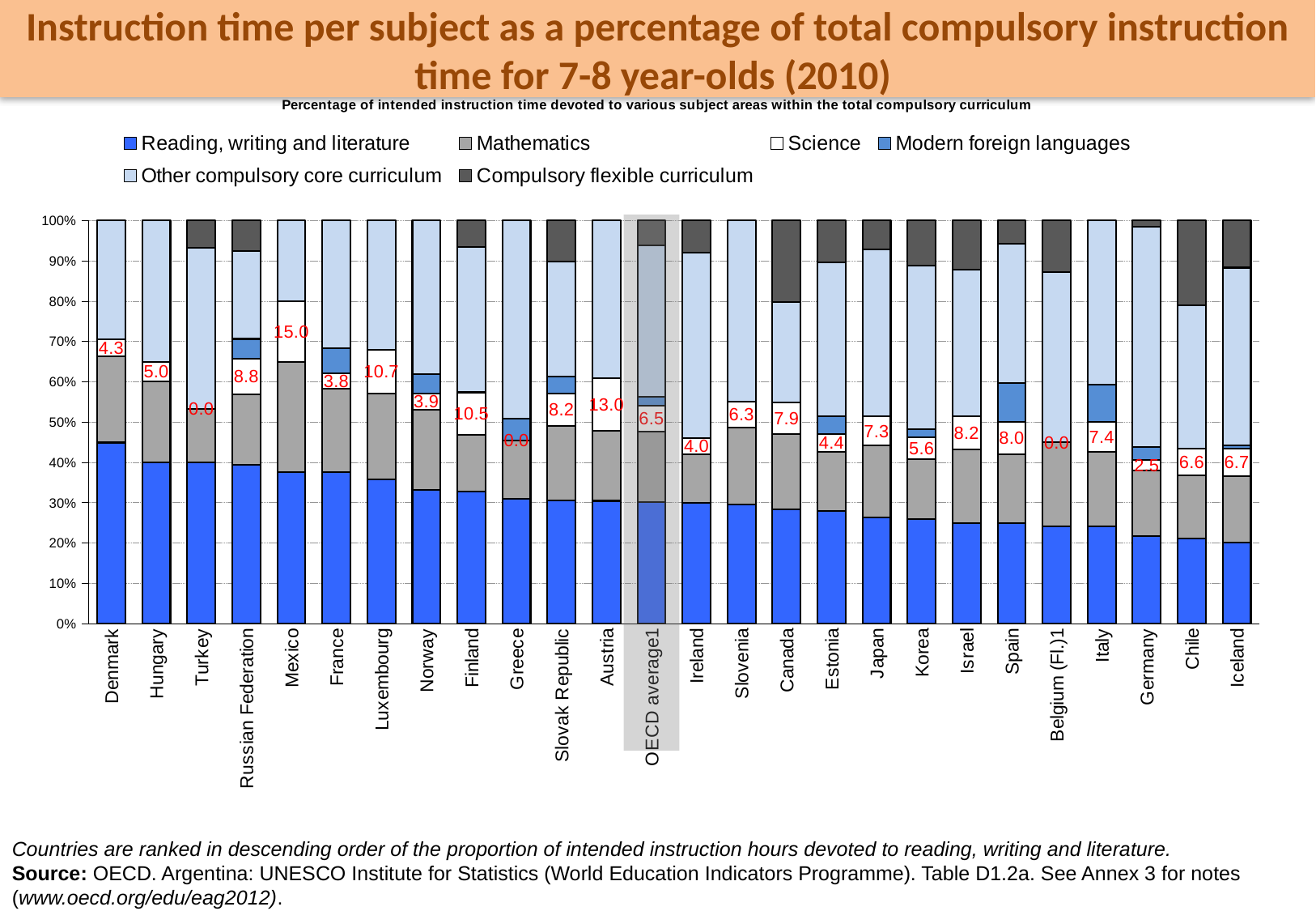
How many countries/categories are shown along the x axis? 26 What data label is printed on the bar for OECD average1? 6.5 Does the Reading, writing and literature segment rise or fall from left to right across the countries? fall What is the difference between the printed data labels for Mexico and Austria? 2.0 Which category on the x axis is highlighted with a grey shaded background? OECD average1 What kind of chart is shown on the slide? Stacked bar chart How many series does the legend list? 6 Which country has the highest printed data label on its bar? Mexico Which has the larger printed data label, Austria or Slovak Republic? Austria What data label is printed on the bar for Mexico? 15.0 What data label is printed on the bar for Austria? 13.0 Is the Reading, writing and literature segment for Denmark greater or less than 40%? greater